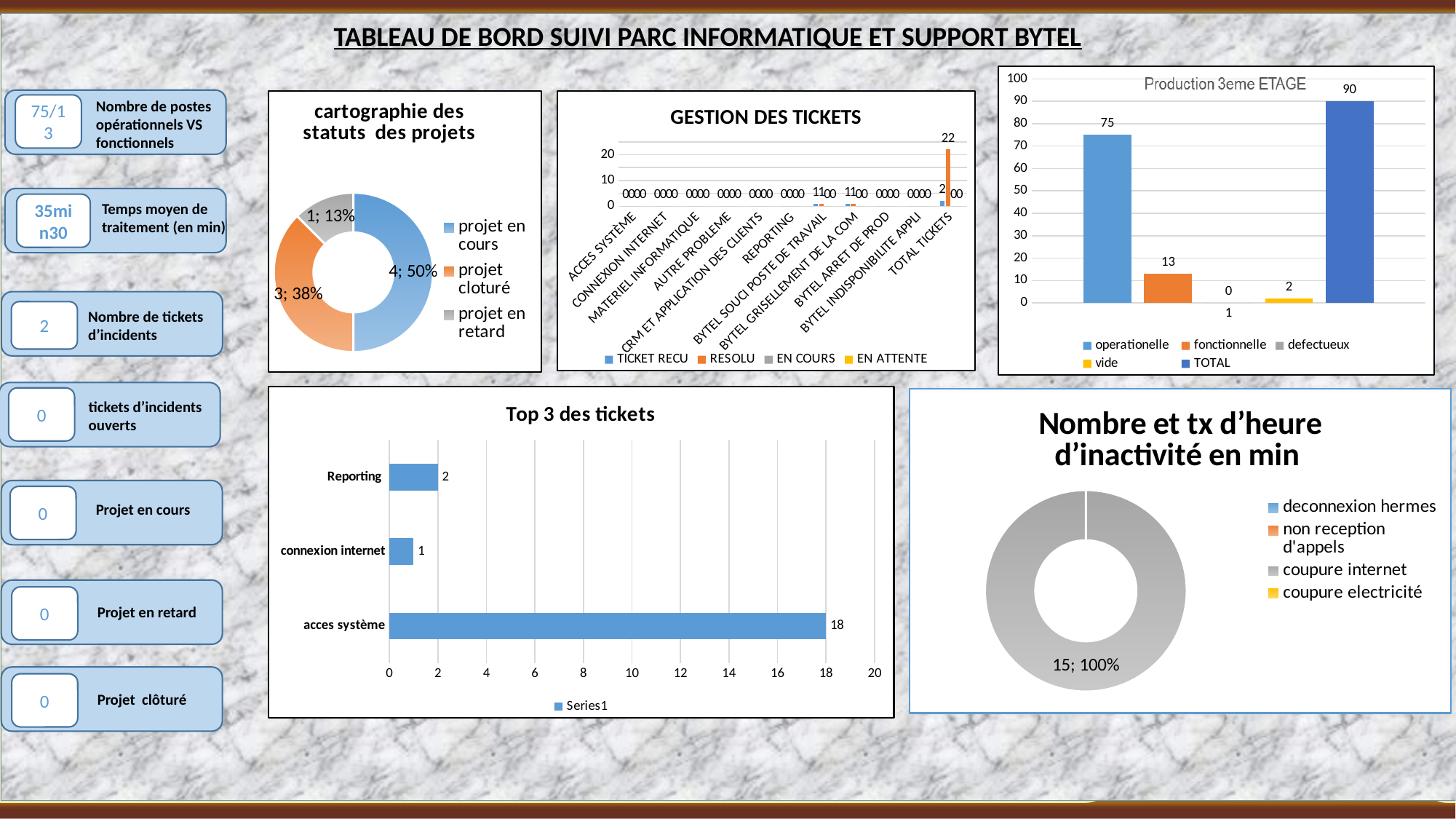
In the 'Nombre et tx d'heure d'inactivité en min' chart, what share does 'coupure internet' have? 100% In the 'Production 3eme ETAGE' chart, what is the value for fonctionnelle? 13 In the 'GESTION DES TICKETS' chart, what is the RESOLU value for TOTAL TICKETS? 22 In the 'GESTION DES TICKETS' chart, how many series does the legend list? 4 In the 'Production 3eme ETAGE' chart, which category has the highest value? TOTAL In the 'Production 3eme ETAGE' chart, what is the value for operationelle? 75 In the 'Top 3 des tickets' chart, which category has the lowest value? connexion internet In the 'cartographie des statuts des projets' chart, what is the value for 'projet en retard'? 1 In the 'Production 3eme ETAGE' chart, what is the difference between TOTAL and operationelle? 15 In the 'cartographie des statuts des projets' chart, what share does 'projet cloturé' have? 38% In the 'Top 3 des tickets' chart, what is the value for acces système? 18 In the 'Top 3 des tickets' chart, how many categories are shown? 3